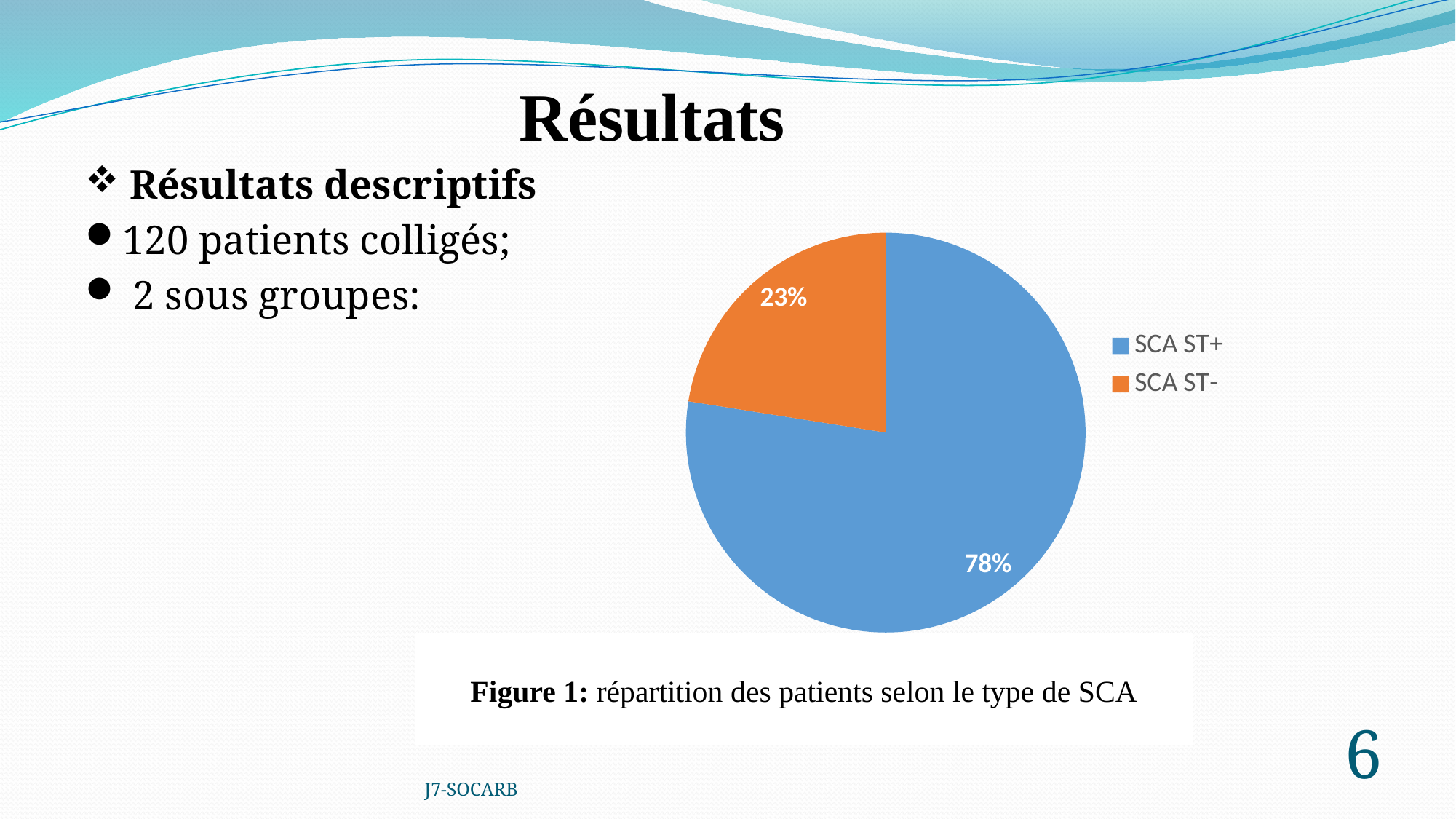
What is the caption of the figure below the pie chart? Figure 1: répartition des patients selon le type de SCA How many entries does the legend list? 2 Which category has the smallest slice of the pie? SCA ST- What kind of chart is shown on the slide? pie chart What is the difference in percentage points between the SCA ST+ and SCA ST- slices? 55 Which is larger, the SCA ST+ slice or the SCA ST- slice? SCA ST+ Which category has the largest slice of the pie? SCA ST+ What share of patients is SCA ST+? 78% How many slices does the pie chart have? 2 What share of patients is SCA ST-? 23% What colour is the SCA ST- slice? orange